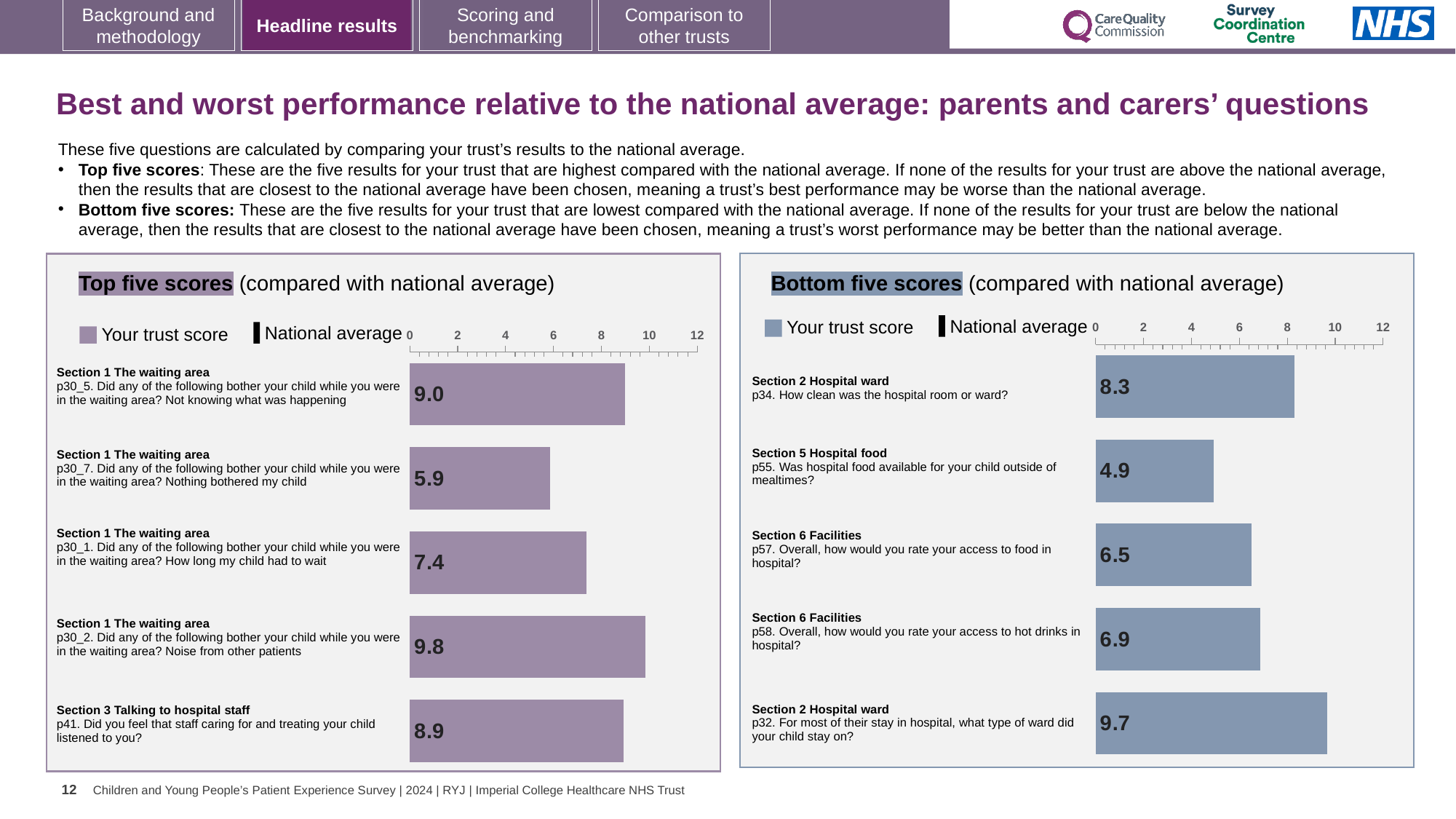
In the Bottom five scores chart, which has the larger trust score: p57 (access to food) or p58 (access to hot drinks)? p58 (access to hot drinks) In the Bottom five scores chart, which question has the lowest trust score? p55. Was hospital food available for your child outside of mealtimes? How many series does the legend of the Top five scores chart list? 2 How many questions are plotted in the Top five scores chart? 5 In the Bottom five scores chart, what is the trust score for p34 (How clean was the hospital room or ward)? 8.3 In the Top five scores chart, which question has the highest trust score? p30_2. Noise from other patients In the Top five scores chart, which question has the lowest trust score? p30_7. Nothing bothered my child What type of chart is the Bottom five scores chart? Bar chart In the Bottom five scores chart, which question has the highest trust score? p32. For most of their stay in hospital, what type of ward did your child stay on? In the Top five scores chart, what is the difference between the trust scores for p30_2 and p30_7? 3.9 In the Bottom five scores chart, what is the difference between the trust scores for p32 and p55? 4.8 In the Top five scores chart, what is the trust score for p30_5 (Not knowing what was happening in the waiting area)? 9.0